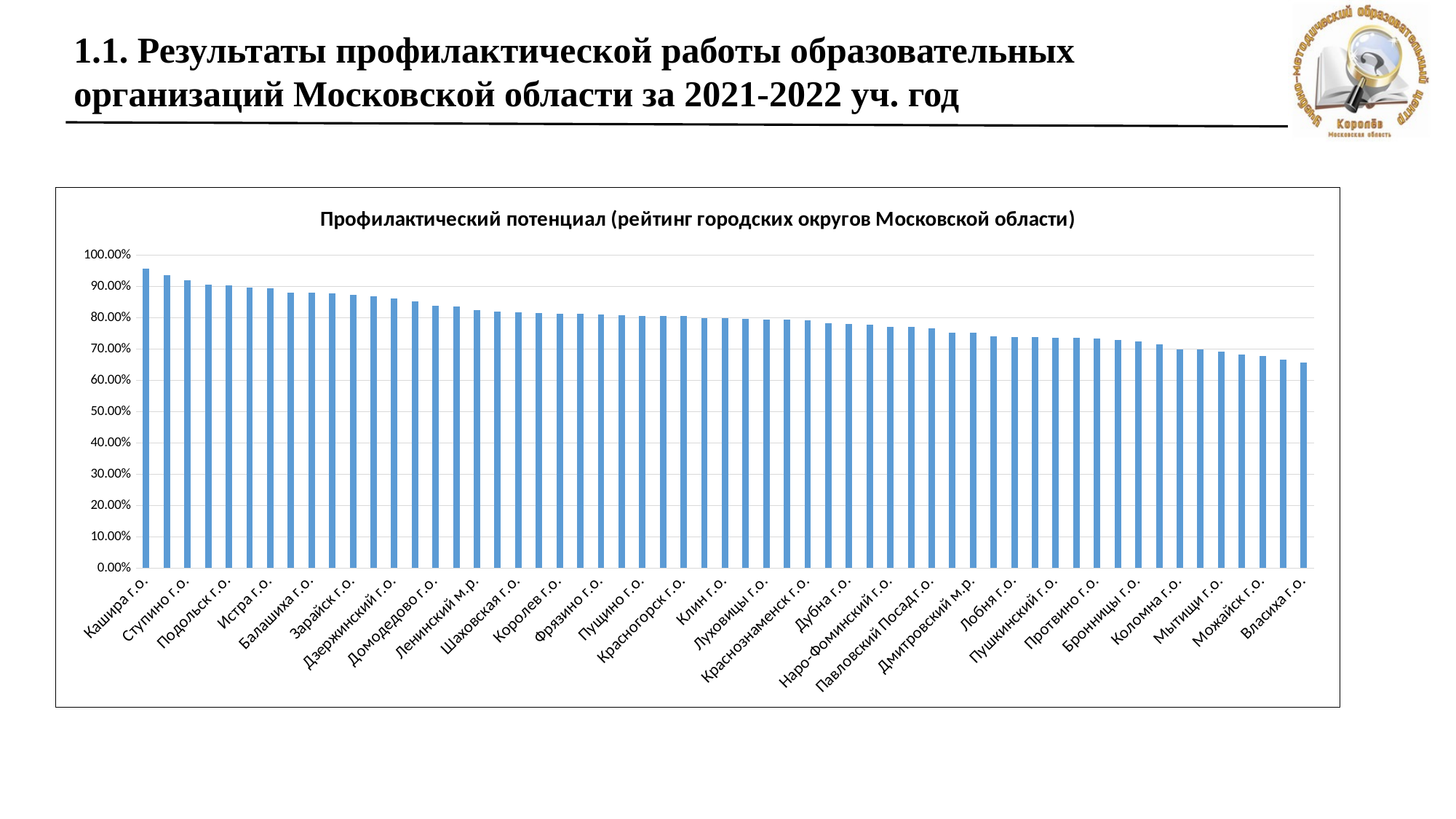
What kind of chart is shown on the slide? bar chart Which category has the lowest value in the chart? Власиха г.о. Which has the larger value, Ступино г.о. or Коломна г.о.? Ступино г.о. Do the values rise or fall from left to right along the x axis? fall Which category has the highest value in the chart? Кашира г.о. Which has the larger value, Балашиха г.о. or Дубна г.о.? Балашиха г.о. Is the value for Домодедово г.о. greater or less than 80.00%? greater Is the value for Кашира г.о. greater or less than 90.00%? greater Is the value for Балашиха г.о. greater or less than 90.00%? less What is the title of the chart? Профилактический потенциал (рейтинг городских округов Московской области)